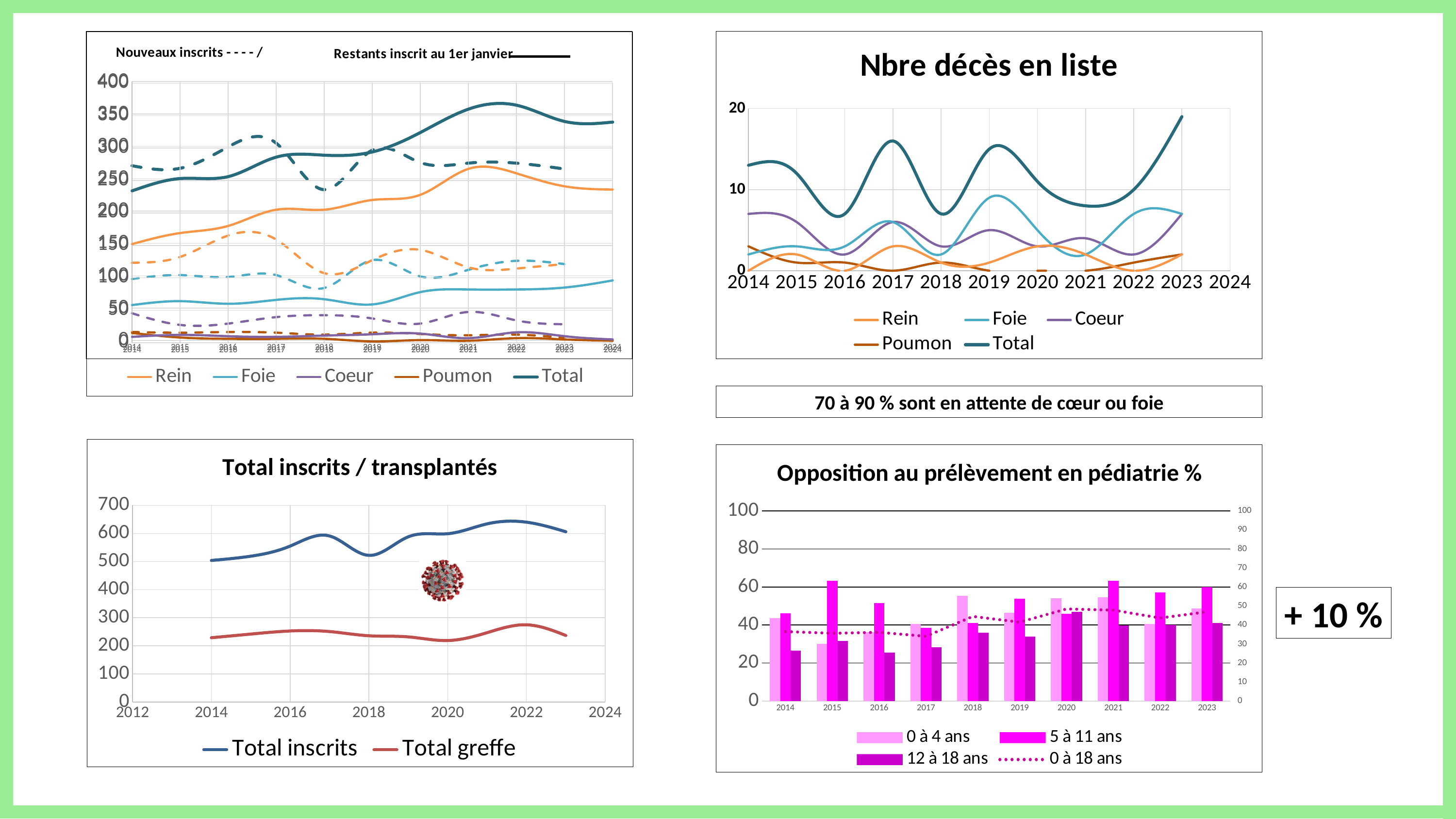
How many series does the legend of the 'Nbre décès en liste' chart list? 5 How many series does the legend of the 'Total inscrits / transplantés' chart list? 2 In the 'Total inscrits / transplantés' chart, is the value for Total inscrits in 2014 greater or less than 400? greater In the 'Total inscrits / transplantés' chart, which series is higher in 2020, Total inscrits or Total greffe? Total inscrits What kind of chart is the 'Nbre décès en liste' chart? line chart In the 'Nbre décès en liste' chart, is the value for Total in 2023 greater or less than 10? greater In the 'Nbre décès en liste' chart, is the value for Total in 2016 greater or less than 10? less What kind of chart is the 'Opposition au prélèvement en pédiatrie %' chart? combination bar and line chart How many years are shown on the x axis of the 'Opposition au prélèvement en pédiatrie %' chart? 10 In the top-left chart, which series does the solid dark line at the top represent according to the legend? Total In the 'Nbre décès en liste' chart, in which year is the Total series highest? 2023